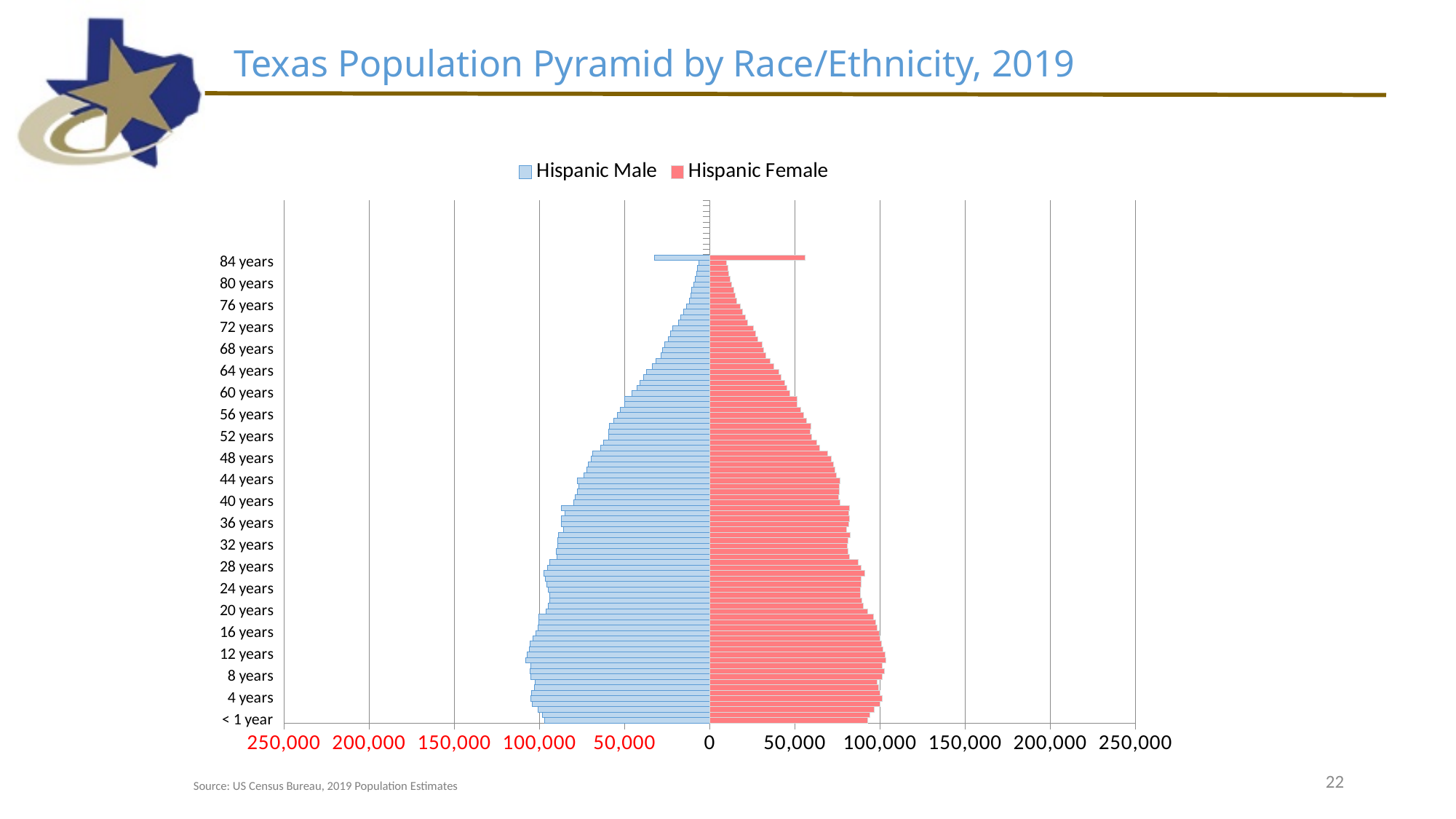
What is the title of the slide's chart? Texas Population Pyramid by Race/Ethnicity, 2019 What kind of chart is shown on the slide? bar chart How many series does the legend list? 2 Is the Hispanic Male value for 64 years greater or less than 50,000? less Do the Hispanic Male values rise or fall as age increases from 40 years to 80 years? fall Which series is shown in red? Hispanic Female Is the Hispanic Male value for 84 years greater or less than 50,000? less Which is larger for Hispanic Female: the value for 84 years or the value for 80 years? 80 years Is the Hispanic Female value for 40 years greater or less than 100,000? less Which is larger for Hispanic Male: the value for 12 years or the value for 64 years? 12 years